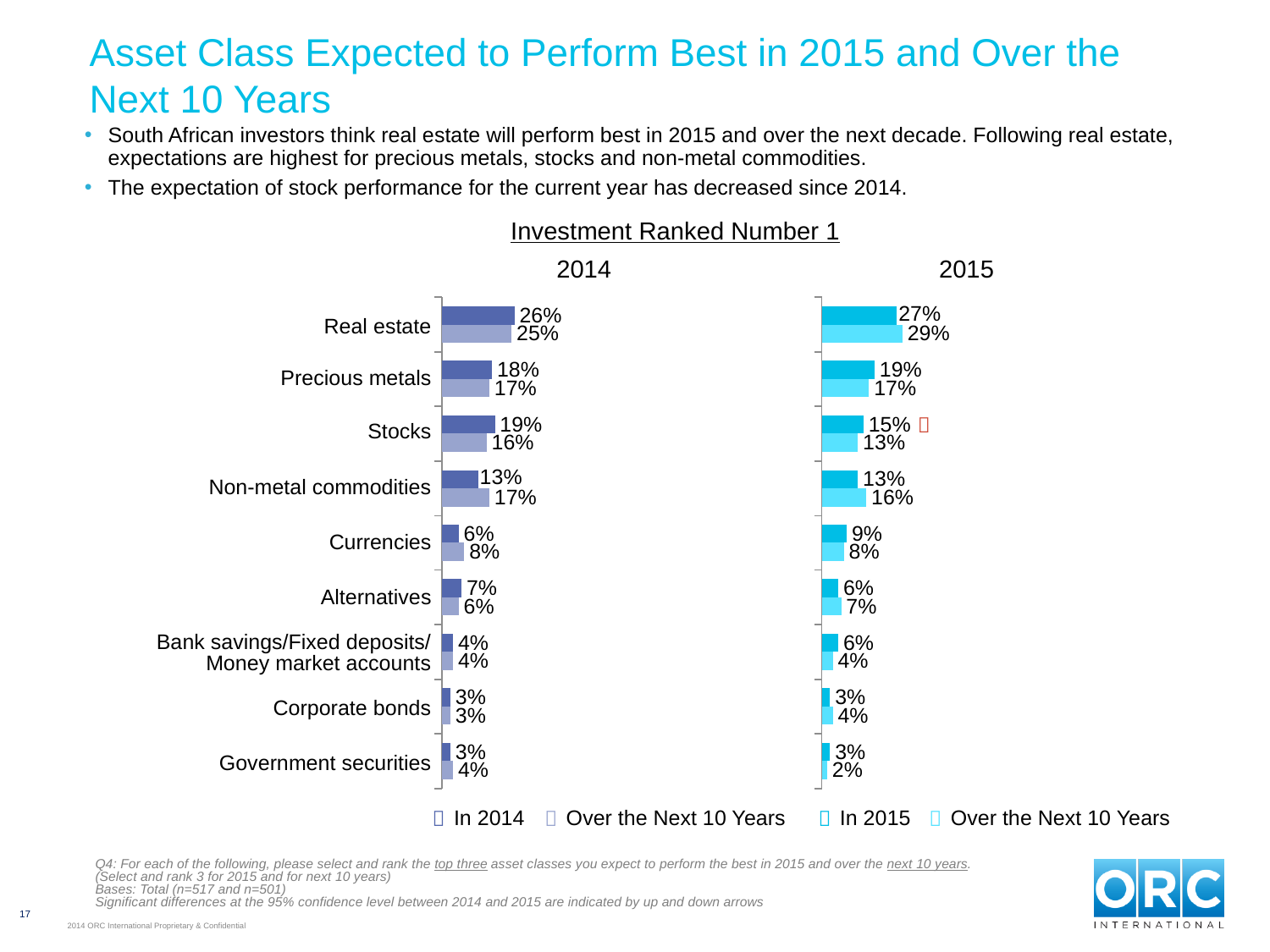
In the 2015 chart, which category has the lowest value in the 'Over the Next 10 Years' series? Government securities In the 2015 chart, which is larger for Currencies: the 'In 2015' value or the 'Over the Next 10 Years' value? In 2015 In the 2014 chart, what is the difference between the 'In 2014' value for Stocks and the 'In 2014' value for Non-metal commodities? 6% In the 2014 chart, which category has the highest value in the 'In 2014' series? Real estate In the 2015 chart, what is the value for Real estate in the 'Over the Next 10 Years' series? 29% How many categories are shown in the 2014 chart? 9 What is the shared title above the two charts? Investment Ranked Number 1 In the 2014 chart, what is the value for Real estate in the 'In 2014' series? 26% What type of chart is the 2014 chart? Bar chart In the 2015 chart, what is the value for Stocks in the 'In 2015' series? 15% How many series does the legend list for the 2015 chart? 2 In the 2015 chart, what is the difference between the 'Over the Next 10 Years' value and the 'In 2015' value for Non-metal commodities? 3%